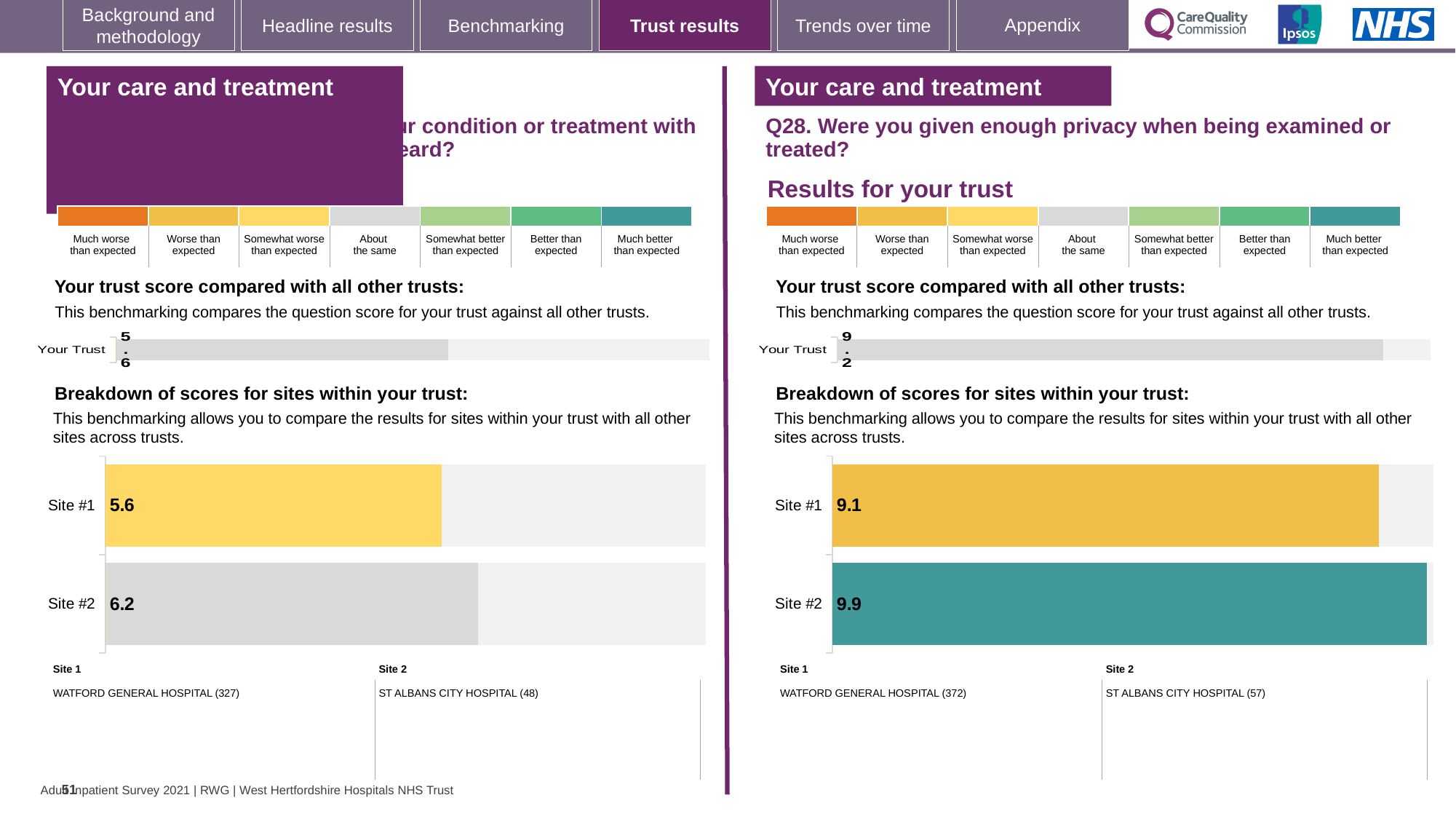
On the right-hand chart (Q28), which site has the higher score? Site #2 On the right-hand chart (Q28, privacy when being examined or treated), what is the score for Site #1? 9.1 On the right-hand side (Q28), what is the 'Your Trust' score shown in the trust benchmarking bar? 9.2 On the left-hand site breakdown chart, what is the difference between the Site #2 and Site #1 scores? 0.6 On the right-hand chart (Q28), what is the difference between the Site #2 and Site #1 scores? 0.8 On the left-hand site breakdown chart, what is the score for Site #2? 6.2 On the right-hand chart (Q28), what is the score for Site #2? 9.9 On the left-hand site breakdown chart, which site has the lower score? Site #1 On the left-hand site breakdown chart, what is the score for Site #1? 5.6 What type of chart is used for the site breakdown on the right-hand side (Q28)? Bar chart How many sites are shown in the site breakdown chart on the right-hand side (Q28)? 2 On the left-hand side, what is the 'Your Trust' score shown in the trust benchmarking bar? 5.6